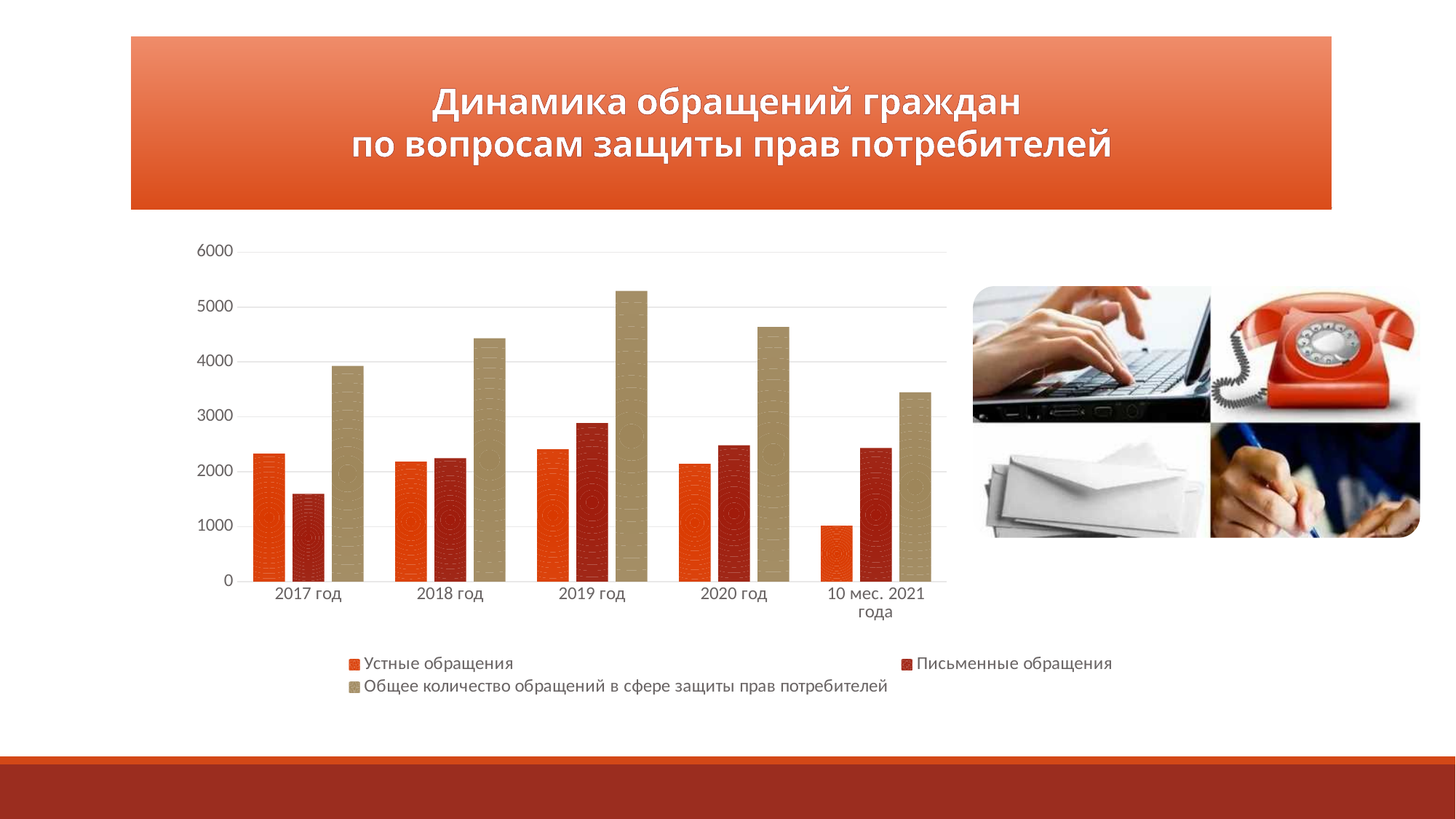
In which period is the value for 'Общее количество обращений в сфере защиты прав потребителей' the highest? 2019 год How many categories (time periods) are shown on the x axis? 5 Does the value for 'Общее количество обращений в сфере защиты прав потребителей' rise or fall from 2017 год to 2019 год? rise In which period is the value for 'Устные обращения' the lowest? 10 мес. 2021 года How many series does the legend list? 3 Is the value for 'Письменные обращения' in 2017 год greater or less than 2000? less In which period is the value for 'Общее количество обращений в сфере защиты прав потребителей' the lowest? 10 мес. 2021 года In 2017 год, which is larger: 'Устные обращения' or 'Письменные обращения'? Устные обращения In 2019 год, which is larger: 'Устные обращения' or 'Письменные обращения'? Письменные обращения What kind of chart is shown on the slide? Bar chart Is the value for 'Устные обращения' in 10 мес. 2021 года greater or less than 1500? less Is the value for 'Общее количество обращений в сфере защиты прав потребителей' in 2019 год greater or less than 5000? greater